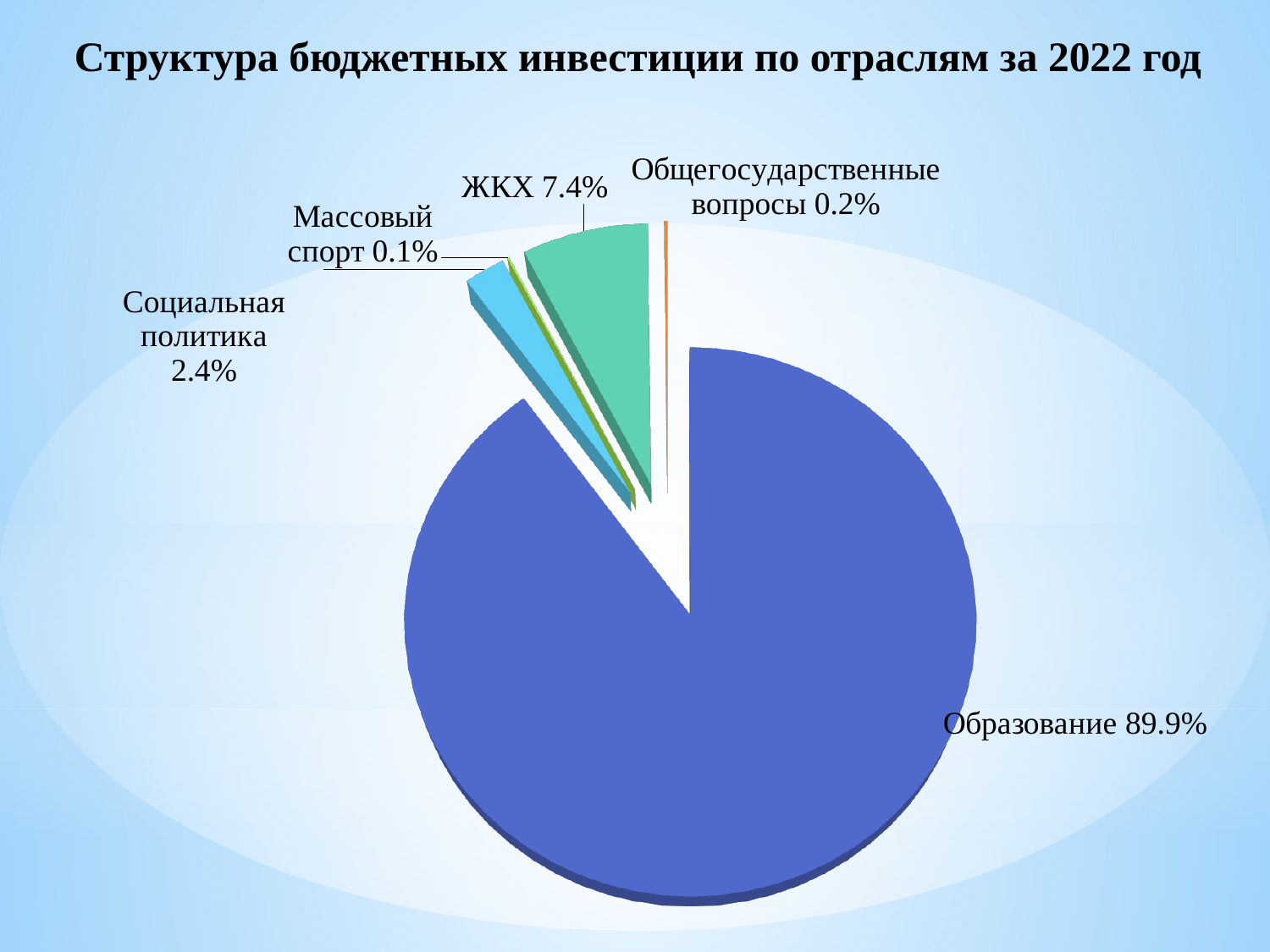
How many slices does the pie chart have? 5 What is the value for Массовый спорт? 0.1% What is the difference between the shares of ЖКХ and Социальная политика? 5.0% What share of budget investments goes to Образование? 89.9% What is the title of the chart? Структура бюджетных инвестиции по отраслям за 2022 год Which sector has the smallest share of budget investments? Массовый спорт Which sector has the largest share of budget investments? Образование What is the value for Общегосударственные вопросы? 0.2% What is the value for ЖКХ? 7.4% What is the value for Социальная политика? 2.4% What type of chart is shown on the slide? Pie chart Which is larger, the share for Социальная политика or the share for Общегосударственные вопросы? Социальная политика